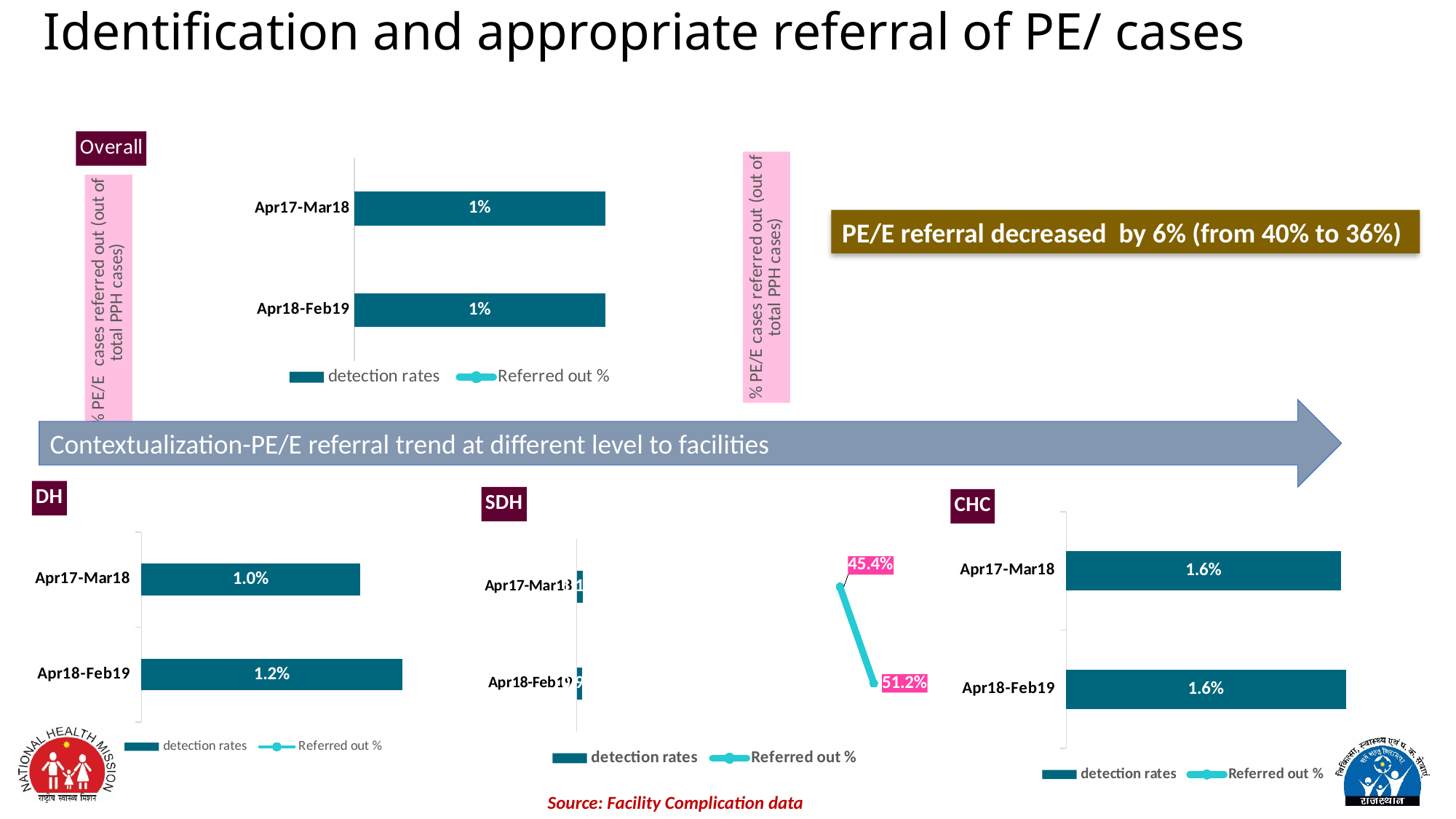
In the SDH chart, did the Referred out % rise or fall from Apr17-Mar18 to Apr18-Feb19? rise In the DH chart, what is the detection rate for Apr18-Feb19? 1.2% In the CHC chart, what is the detection rate for Apr18-Feb19? 1.6% In the DH chart, what is the difference in detection rate between Apr18-Feb19 and Apr17-Mar18? 0.2% In the Overall chart, what is the detection rate for Apr17-Mar18? 1% How many series does the legend of the CHC chart list? 2 In the SDH chart, what is the Referred out % for Apr17-Mar18? 45.4% In the Overall chart, what is the detection rate for Apr18-Feb19? 1% What kind of chart is the DH chart? bar chart In the DH chart, what is the detection rate for Apr17-Mar18? 1.0% In the DH chart, which period has the higher detection rate? Apr18-Feb19 In the SDH chart, what is the Referred out % for Apr18-Feb19? 51.2%